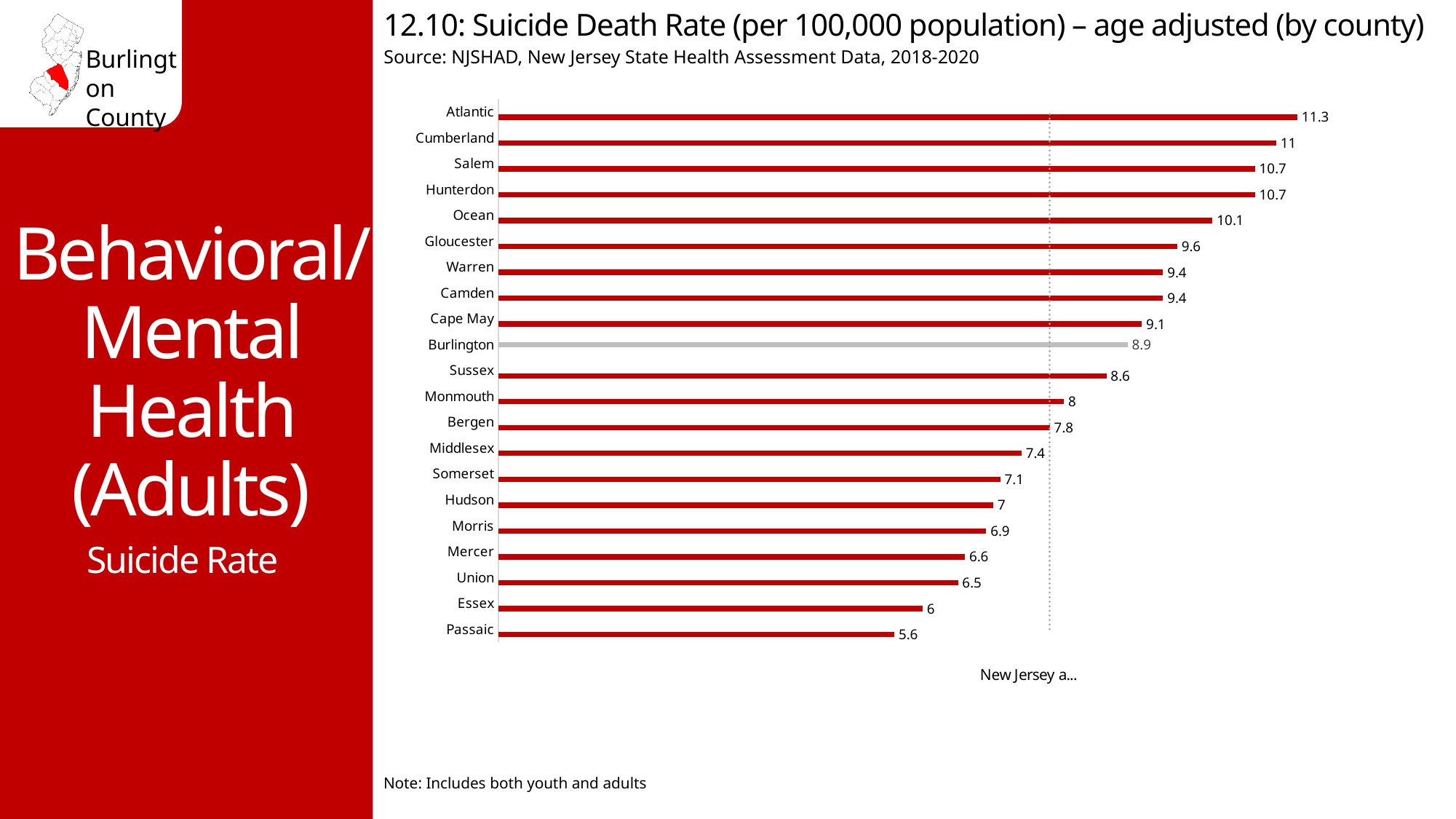
How many counties are shown in the chart? 21 What is the difference between the suicide death rates of Burlington and Sussex counties? 0.3 What is the suicide death rate for Atlantic County? 11.3 Which county has a higher suicide death rate, Ocean or Gloucester? Ocean Which county has the highest suicide death rate? Atlantic Which county has a higher suicide death rate, Bergen or Monmouth? Monmouth Which county's bar is shown in grey rather than red? Burlington What is the suicide death rate for Passaic County? 5.6 What type of chart is used on this slide? Bar chart What is the difference between the suicide death rates of Atlantic and Passaic counties? 5.7 What is the suicide death rate for Burlington County? 8.9 Which county has the lowest suicide death rate? Passaic